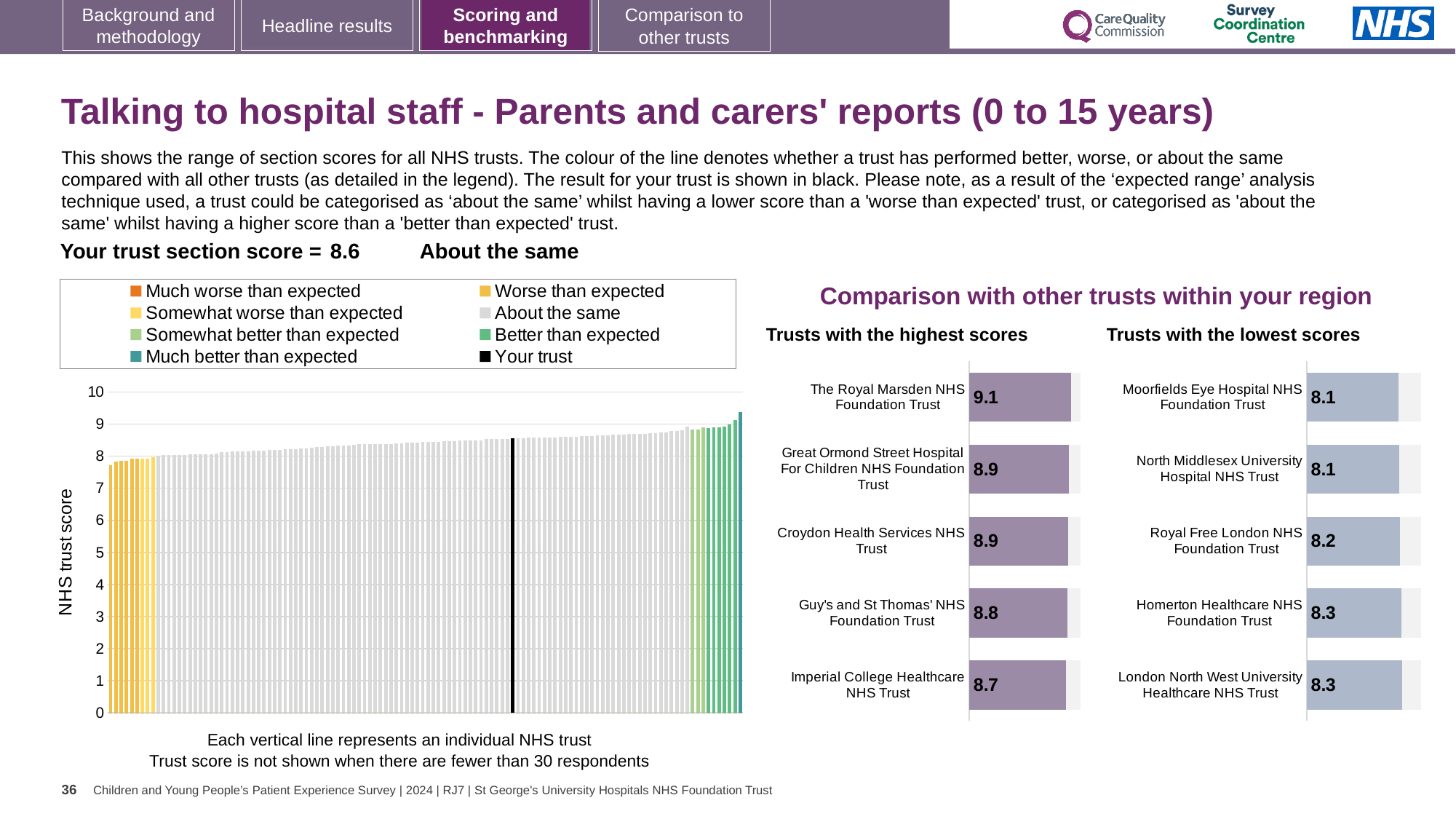
In the 'Trusts with the highest scores' chart, what is the score for Imperial College Healthcare NHS Trust? 8.7 In the left-hand chart of all NHS trusts, do the trust scores rise or fall from left to right? Rise In the 'Trusts with the highest scores' chart, which has the larger score: Croydon Health Services NHS Trust or Guy's and St Thomas' NHS Foundation Trust? Croydon Health Services NHS Trust In the 'Trusts with the highest scores' chart, what is the difference between the scores of The Royal Marsden NHS Foundation Trust and Imperial College Healthcare NHS Trust? 0.4 How many entries does the legend of the left-hand chart of all NHS trusts list? 8 In the 'Trusts with the highest scores' chart, what is the score for The Royal Marsden NHS Foundation Trust? 9.1 In the 'Trusts with the lowest scores' chart, what is the difference between the scores of Homerton Healthcare NHS Foundation Trust and Moorfields Eye Hospital NHS Foundation Trust? 0.2 In the 'Trusts with the highest scores' chart, which trust has the highest score? The Royal Marsden NHS Foundation Trust How many trusts are shown in the 'Trusts with the lowest scores' chart? 5 In the 'Trusts with the lowest scores' chart, what is the score for Homerton Healthcare NHS Foundation Trust? 8.3 In the 'Trusts with the lowest scores' chart, what is the score for Royal Free London NHS Foundation Trust? 8.2 What kind of chart is the left-hand chart showing the range of section scores for all NHS trusts? Bar chart